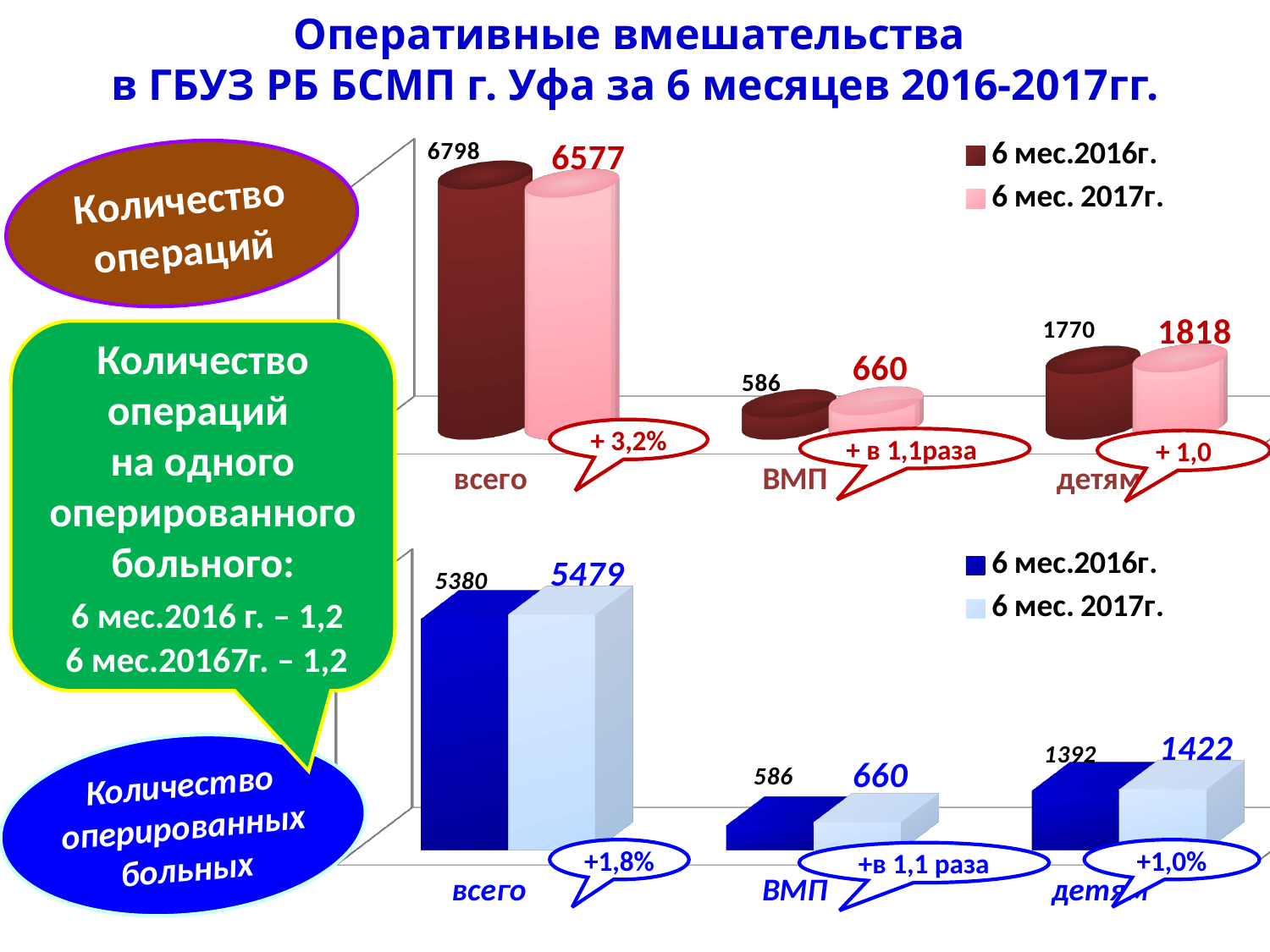
In the bottom chart (Количество оперированных больных), what is the value for 'детям' in the '6 мес.2016г.' series? 1392 In the top chart (Количество операций), what is the value for 'ВМП' in the '6 мес. 2017г.' series? 660 What type of chart is the bottom chart (Количество оперированных больных)? Bar chart In the top chart (Количество операций), what is the difference between the 2016 and 2017 values for 'всего'? 221 In the bottom chart (Количество оперированных больных), what is the value for 'всего' in the '6 мес. 2017г.' series? 5479 How many series does the legend of the bottom chart list? 2 In the bottom chart (Количество оперированных больных), which category has the highest value in the '6 мес. 2017г.' series? всего In the top chart (Количество операций), which is larger for 'детям': the 2016 value or the 2017 value? 2017 (1818) In the top chart (Количество операций), what is the value for 'всего' in the '6 мес.2016г.' series? 6798 In the top chart (Количество операций), what is the value for 'детям' in the '6 мес. 2017г.' series? 1818 In the top chart (Количество операций), which category has the lowest value in the '6 мес.2016г.' series? ВМП In the bottom chart (Количество оперированных больных), what is the difference between the 2017 and 2016 values for 'ВМП'? 74